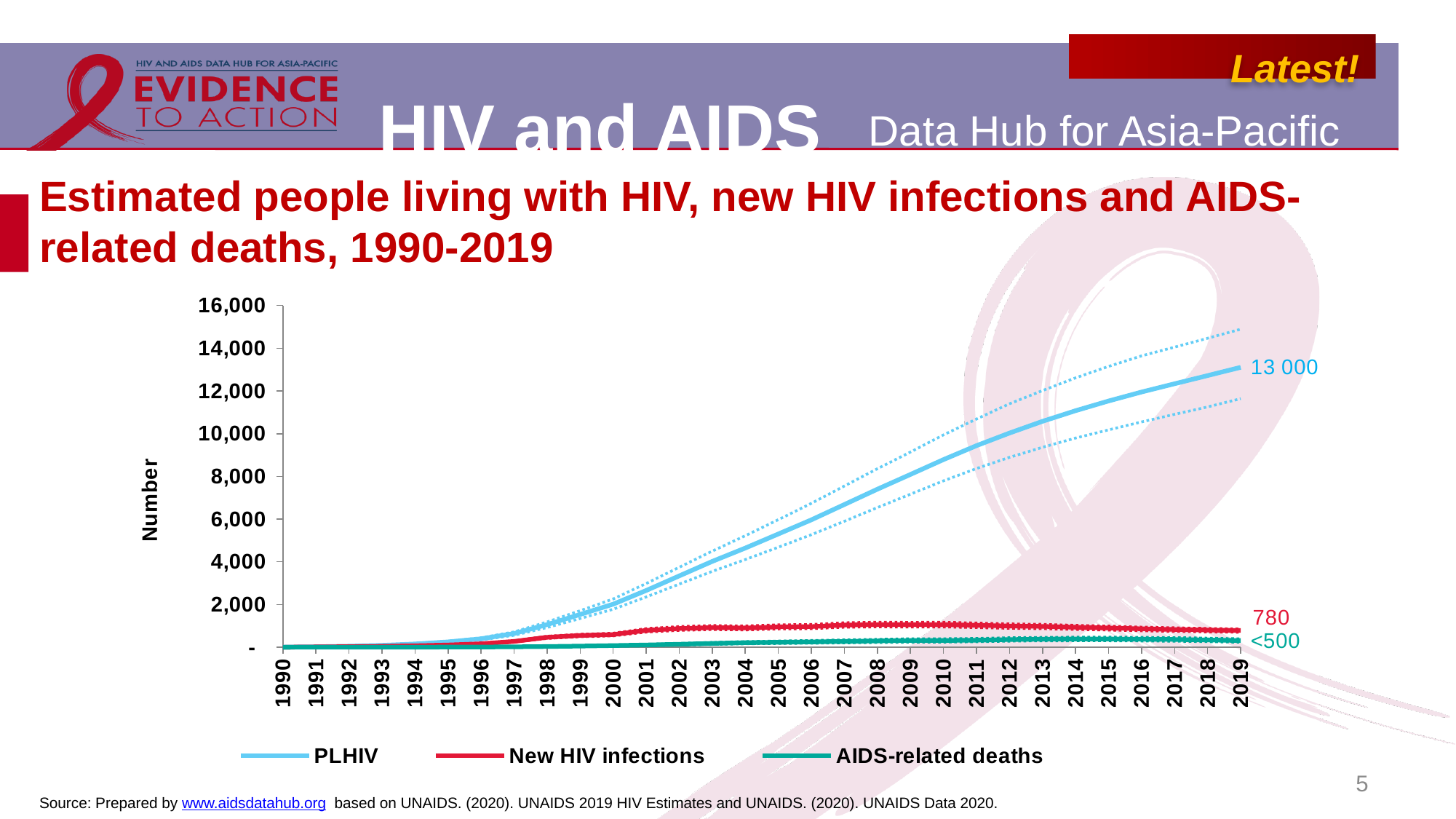
What is the estimated number of people living with HIV (PLHIV) in 2019 according to the data label? 13 000 Does the PLHIV line rise or fall from 1990 to 2019? Rises What is the estimated number of new HIV infections in 2019 according to the data label? 780 Is the PLHIV value in 2000 greater or less than 4,000? less What is the estimated number of AIDS-related deaths in 2019 according to the data label? <500 How many series does the legend list? 3 What kind of chart is shown on the slide? Line chart In 2019, which is larger: PLHIV or new HIV infections? PLHIV Is the PLHIV value in 2010 greater or less than 8,000? greater What is the label of the vertical axis? Number Which series has the highest value in 2019? PLHIV Which series has the lowest value in 2019? AIDS-related deaths